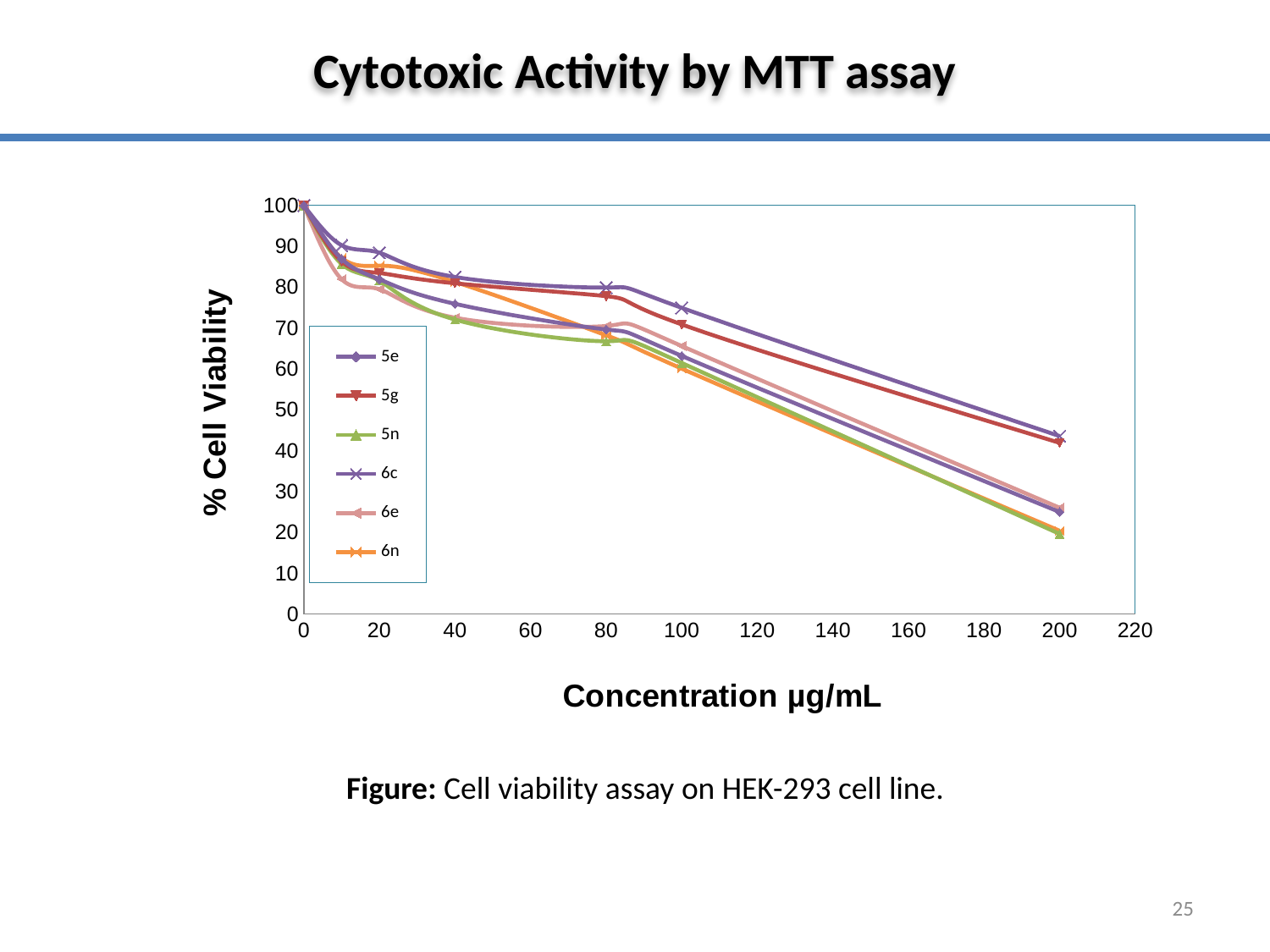
What is the title of the y axis? % Cell Viability Do the % cell viability values for series 6c rise or fall as concentration increases along the x axis? fall At 100 µg/mL, which series has the larger % cell viability, 6c or 5e? 6c At 200 µg/mL, which series has the larger % cell viability, 6c or 5n? 6c Is the value for series 6c at 100 µg/mL greater or less than 70? greater Is the value for series 5n at 200 µg/mL greater or less than 30? less Is the value for series 5g at 200 µg/mL greater or less than 50? less What is the title of the x axis? Concentration µg/mL How many series does the legend list? 6 What is the % cell viability for series 5g at a concentration of 0 µg/mL? 100 What kind of chart is shown on the slide? line chart